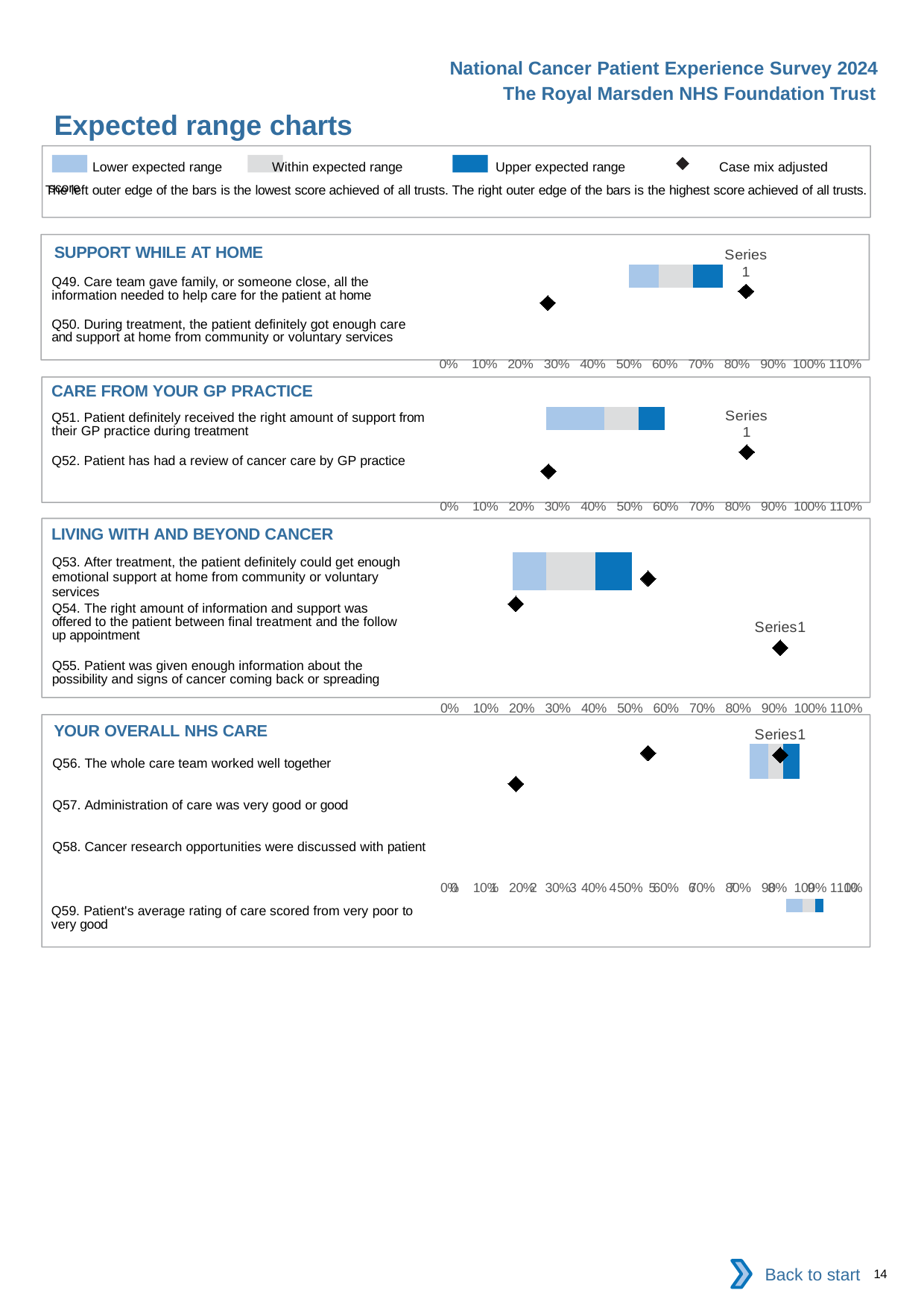
In the LIVING WITH AND BEYOND CANCER chart, is the diamond marker labelled Series1 greater or less than 80%? greater In the SUPPORT WHILE AT HOME chart, is the diamond marker labelled Series 1 greater or less than 70%? greater What kind of chart is used on this slide to show the expected ranges? Bar chart How many entries does the legend at the top of the slide list? 4 How many separate chart sections are shown on the slide? 4 How many questions are listed in the CARE FROM YOUR GP PRACTICE chart? 2 How many questions are listed in the LIVING WITH AND BEYOND CANCER chart? 3 In the CARE FROM YOUR GP PRACTICE chart, is the diamond marker labelled Series 1 greater or less than 70%? greater What is the highest tick label shown on the x axis of the charts? 110% According to the legend, what does the black diamond marker represent? Case mix adjusted score